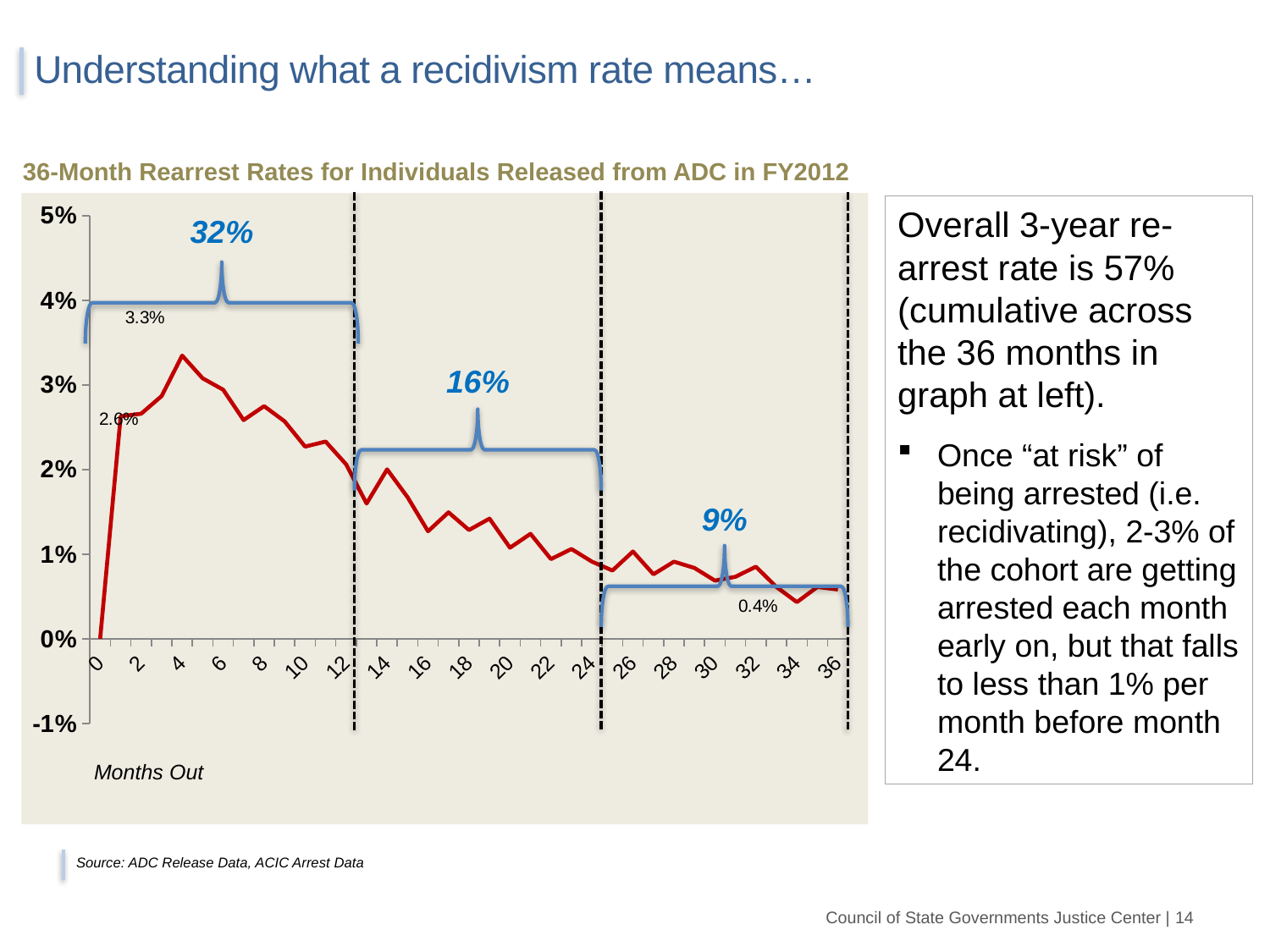
What is the difference between the labeled peak monthly rate (3.3%) and the labeled rate at month 36 (0.4%)? 2.9 percentage points What cumulative rearrest rate is shown for months 12 to 24? 16% What is the label on the x axis of the chart? Months Out What is the title of the chart? 36-Month Rearrest Rates for Individuals Released from ADC in FY2012 After the peak around month 4, does the monthly rearrest rate generally rise or fall as months out increase? fall What kind of chart is shown on the slide? line chart What cumulative rearrest rate is shown for months 24 to 36? 9% Is the monthly rearrest rate at month 20 greater or less than 2%? less Which 12-month period has the highest cumulative rearrest rate? months 0 to 12 (32%) What is the peak monthly rearrest rate labeled on the chart? 3.3% What cumulative rearrest rate is shown for months 0 to 12? 32%